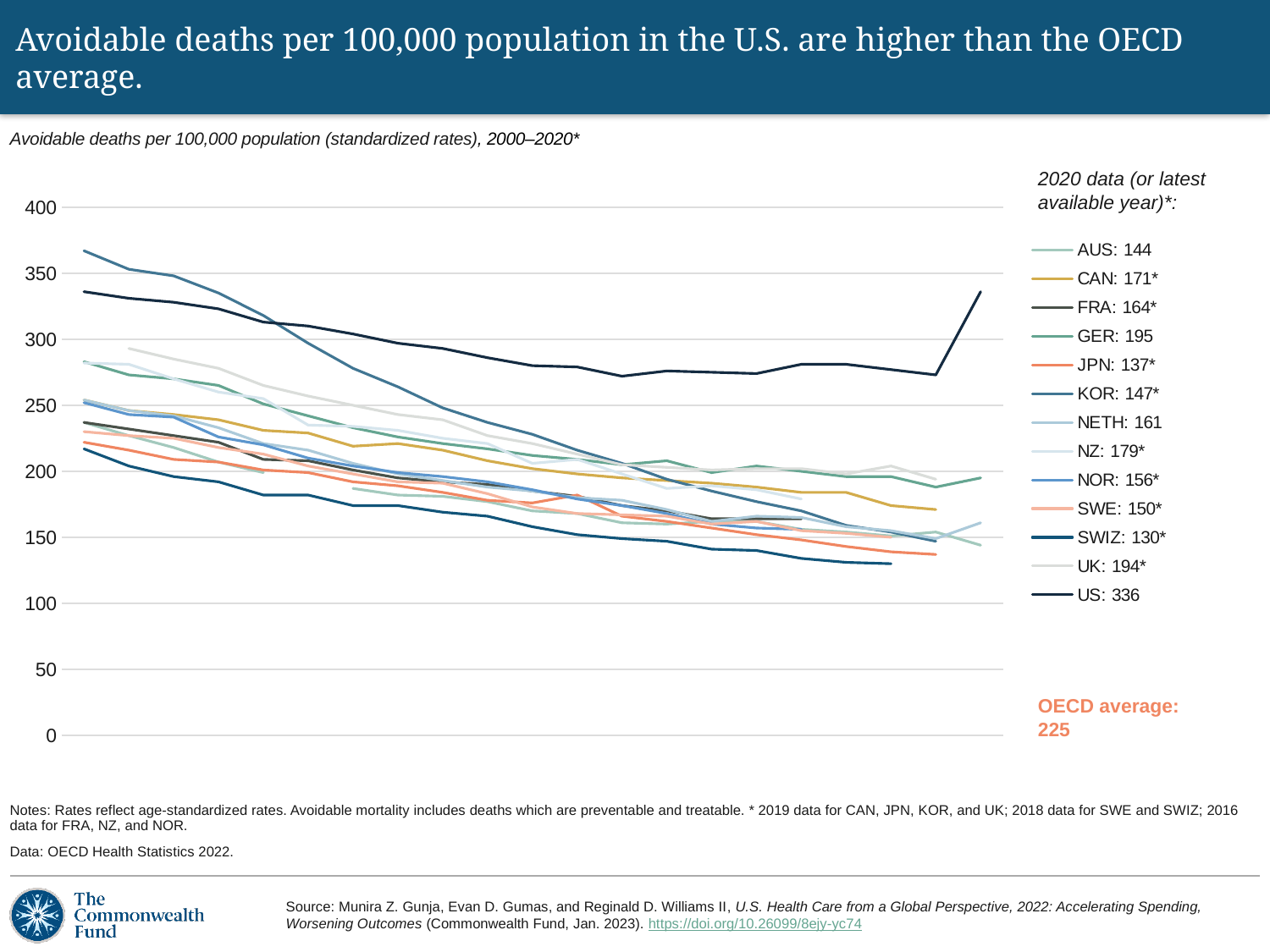
Which country has the lowest avoidable deaths value in the legend? SWIZ By how much does the US value (336) exceed the OECD average (225)? 111 What is the 2020 value for GER shown in the legend? 195 What is the difference between the GER value and the AUS value in the legend? 51 What type of chart is shown on the slide? Line chart What is the 2020 value for NETH shown in the legend? 161 Is the US value at the start of the series (2000) greater or less than 300? greater Which has a higher legend value, NETH or NOR? NETH Which country has the highest avoidable deaths value in the legend? US What is the 2020 (or latest available year) value for the US? 336 How many countries are listed in the legend? 13 What is the 2020 value for AUS shown in the legend? 144